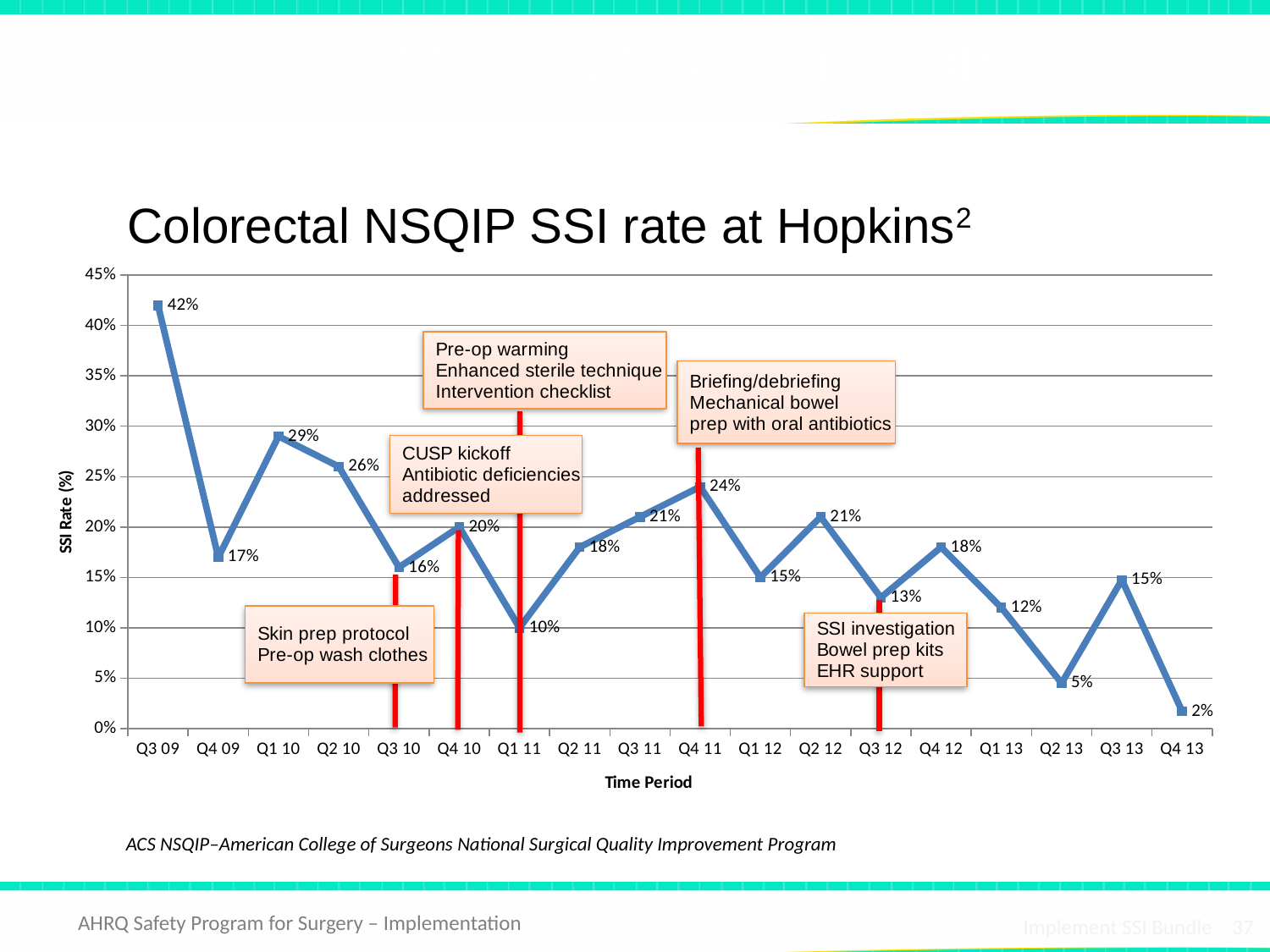
What is the difference between the SSI rate in Q3 09 and Q4 09? 25% What is the SSI rate for Q1 11? 10% What kind of chart is shown on the slide? Line chart Overall, does the SSI rate rise or fall from Q3 09 to Q4 13? Fall Which has a higher SSI rate, Q4 11 or Q1 12? Q4 11 What is the SSI rate for Q3 09? 42% What is the label of the y axis? SSI Rate (%) What is the SSI rate for Q4 13? 2% How many time periods are plotted on the x axis? 18 Is the SSI rate for Q1 10 greater or less than 25%? greater Which time period has the lowest SSI rate? Q4 13 Which time period has the highest SSI rate? Q3 09